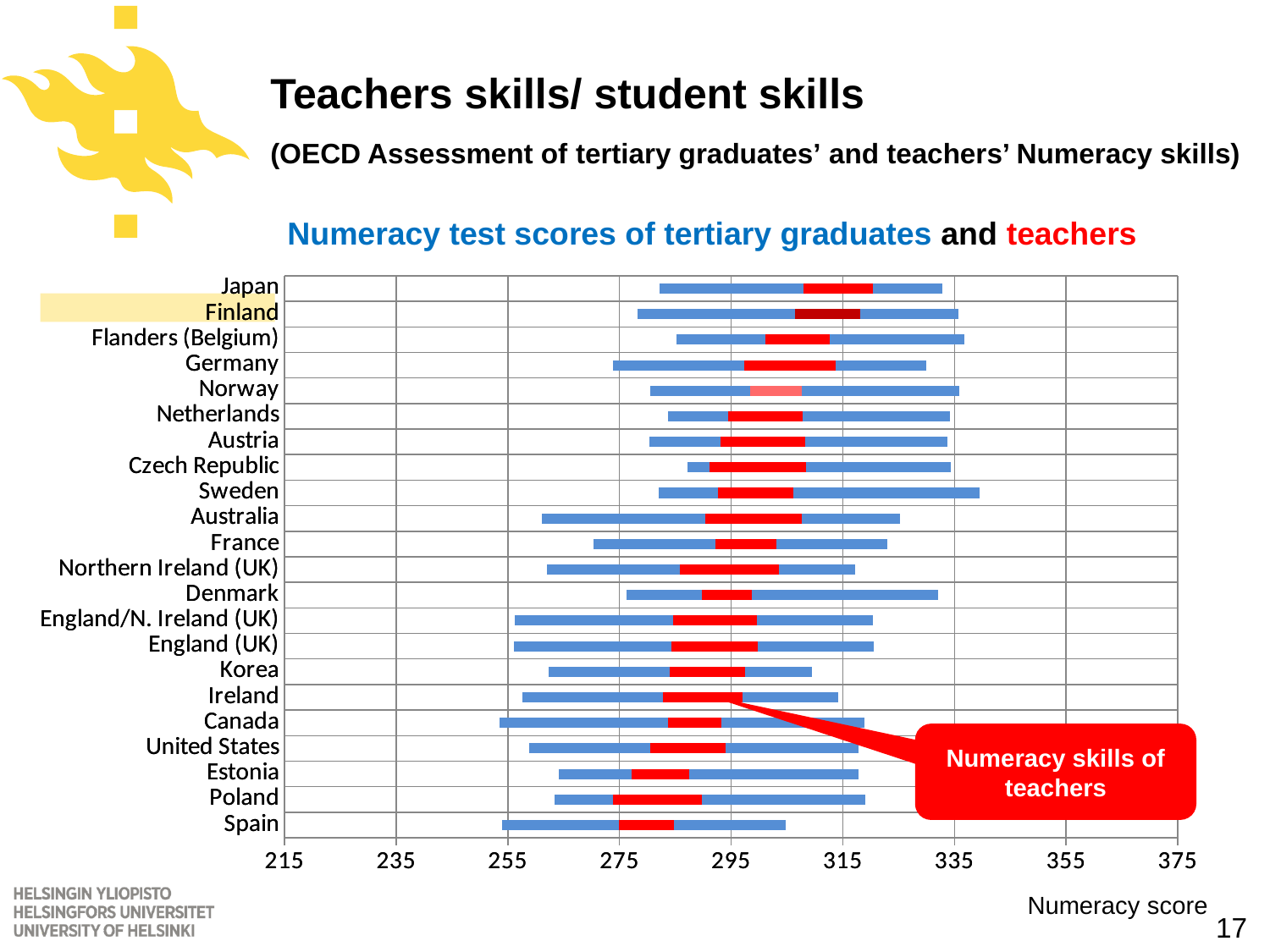
Which has a higher teachers' numeracy score range (red bar), Japan or Poland? Japan Is the right end of the blue bar for Spain greater or less than 315? less What is the title of the chart? Numeracy test scores of tertiary graduates and teachers Is the red bar for Spain greater or less than 295? less What kind of chart is shown on the slide? bar chart What is the label of the horizontal axis? Numeracy score Is the red bar for Finland greater or less than 295? greater Which has a higher teachers' numeracy score range (red bar), Finland or Spain? Finland How many countries or regions are listed on the chart? 22